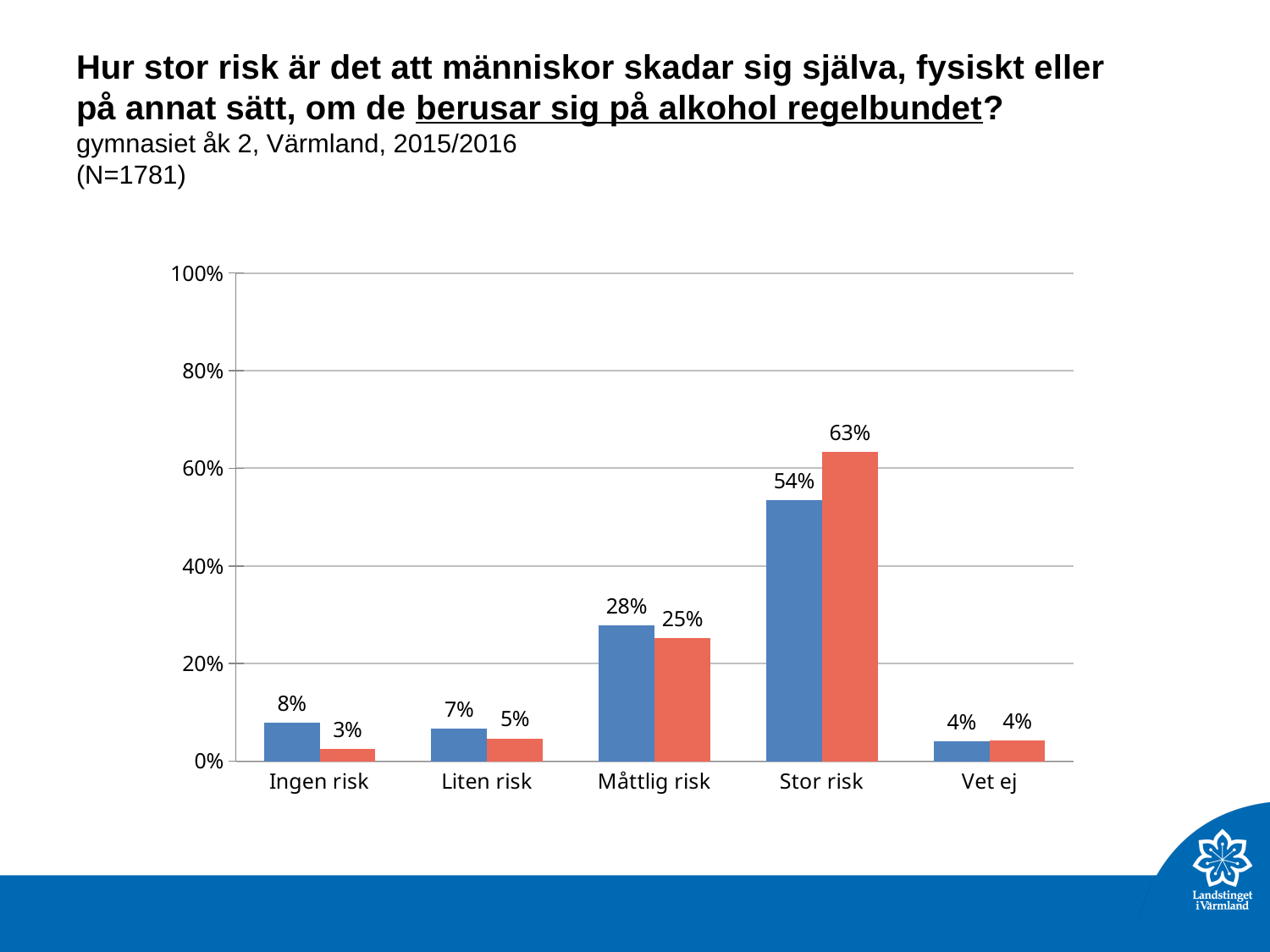
What is the value of the red bar for Ingen risk? 3% What is the sample size (N) stated on the slide? 1781 Which category has the highest value for the red bars? Stor risk What is the difference between the red and blue bars for Stor risk? 9% How many categories are shown on the x axis? 5 Which category has the lowest value for the red bars? Ingen risk For Måttlig risk, which bar is larger, the blue or the red? blue What is the value of the red bar for Stor risk? 63% Is the value of the red bar for Stor risk greater or less than 60%? greater What is the value of the blue bar for Måttlig risk? 28% What is the value of the blue bar for Stor risk? 54% What kind of chart is shown on the slide? bar chart